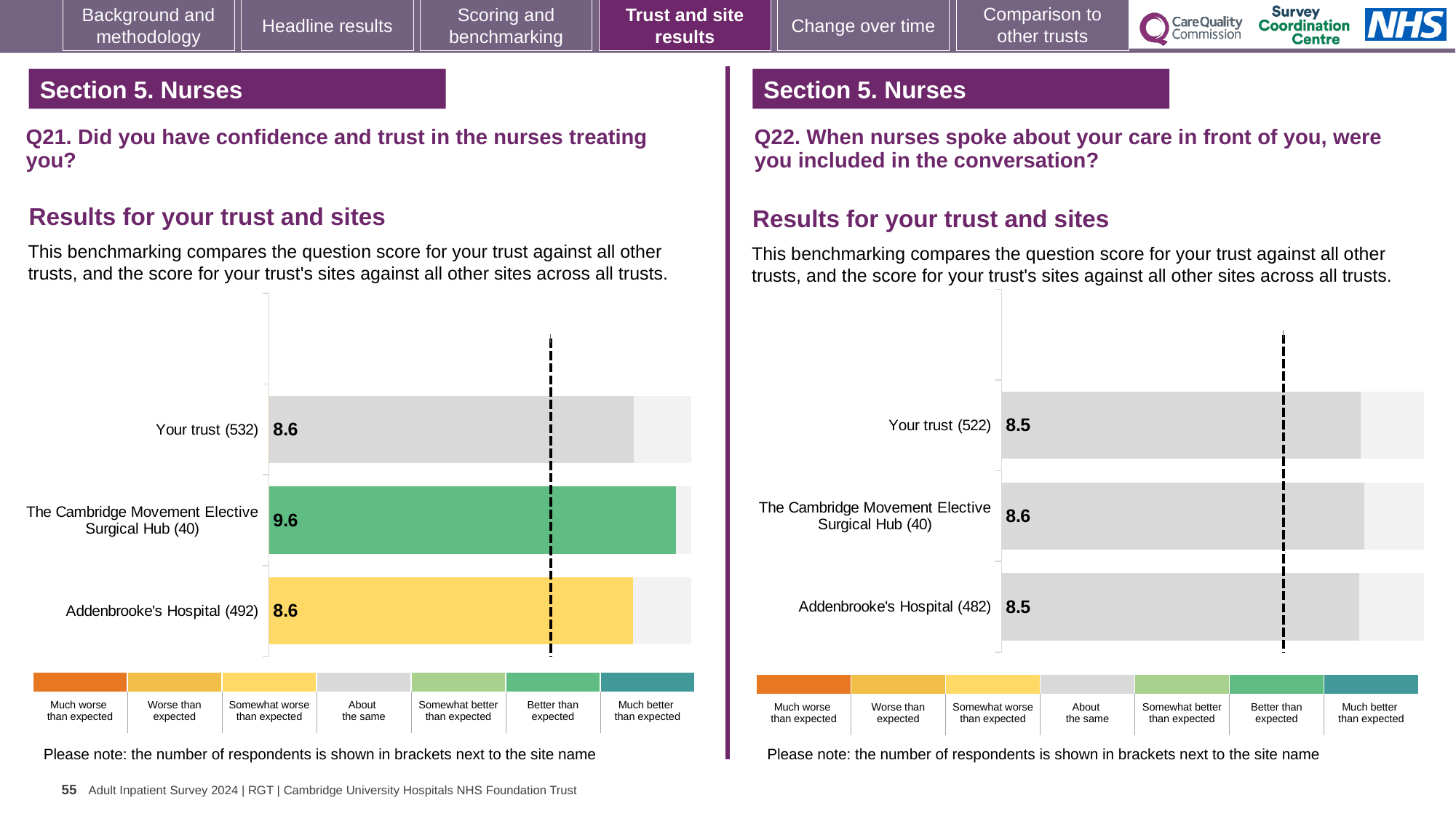
On the Q21 chart (left), which benchmark category does the colour of the bar for The Cambridge Movement Elective Surgical Hub (40) correspond to? Better than expected On the Q22 chart (right), what is the score for Your trust (522)? 8.5 On the Q22 chart (right), what is the score for The Cambridge Movement Elective Surgical Hub (40)? 8.6 What kind of chart is used on the Q21 chart (left)? Bar chart On the Q21 chart (left), what is the score for Your trust (532)? 8.6 On the Q22 chart (right), what is the score for Addenbrooke's Hospital (482)? 8.5 On the Q21 chart (left), what is the score for The Cambridge Movement Elective Surgical Hub (40)? 9.6 On the Q22 chart (right), how many bars are plotted? 3 On the Q21 chart (left), what is the score for Addenbrooke's Hospital (492)? 8.6 On the Q21 chart (left), which site or trust has the highest score? The Cambridge Movement Elective Surgical Hub (40) On the Q21 chart (left), which benchmark category does the colour of the bar for Addenbrooke's Hospital (492) correspond to? Somewhat worse than expected On the Q21 chart (left), what is the difference between the score for The Cambridge Movement Elective Surgical Hub (40) and the score for Your trust (532)? 1.0